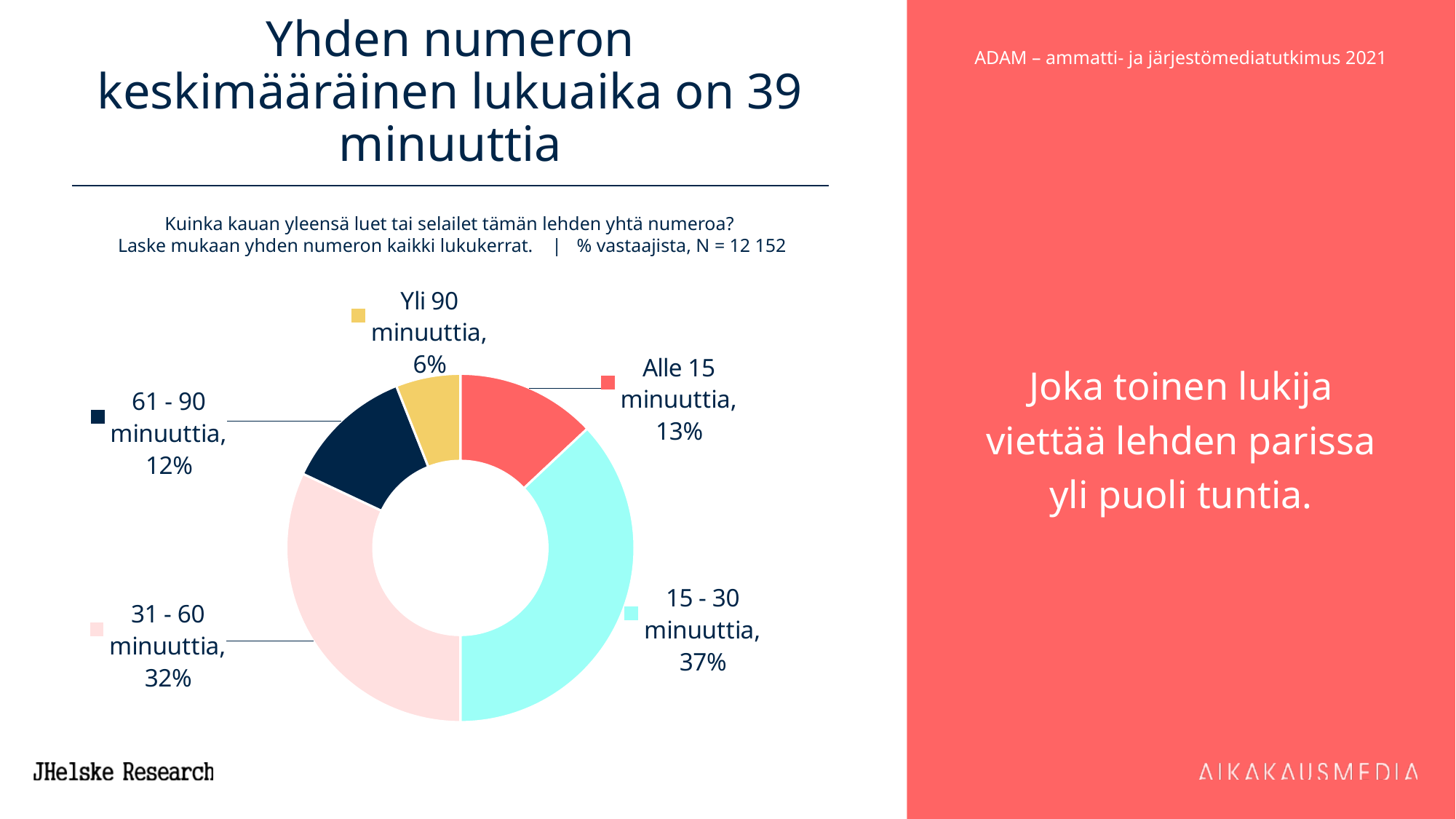
Which reading-time category has the largest share? 15 - 30 minuuttia How many categories does the chart show? 5 What colour is the slice for 15 - 30 minuuttia? Light blue (cyan) What share of respondents read one issue for 15 - 30 minuuttia? 37% What kind of chart is shown on the slide? Doughnut (pie) chart What share of respondents read one issue for 61 - 90 minuuttia? 12% What share of respondents read one issue for Alle 15 minuuttia? 13% Which is larger, the share for Alle 15 minuuttia or the share for 61 - 90 minuuttia? Alle 15 minuuttia Which reading-time category has the smallest share? Yli 90 minuuttia What share of respondents read one issue for Yli 90 minuuttia? 6% What is the difference in percentage points between the 15 - 30 minuuttia and 31 - 60 minuuttia shares? 5 What is the combined share of respondents reading 31 - 60 minuuttia and 61 - 90 minuuttia? 44%